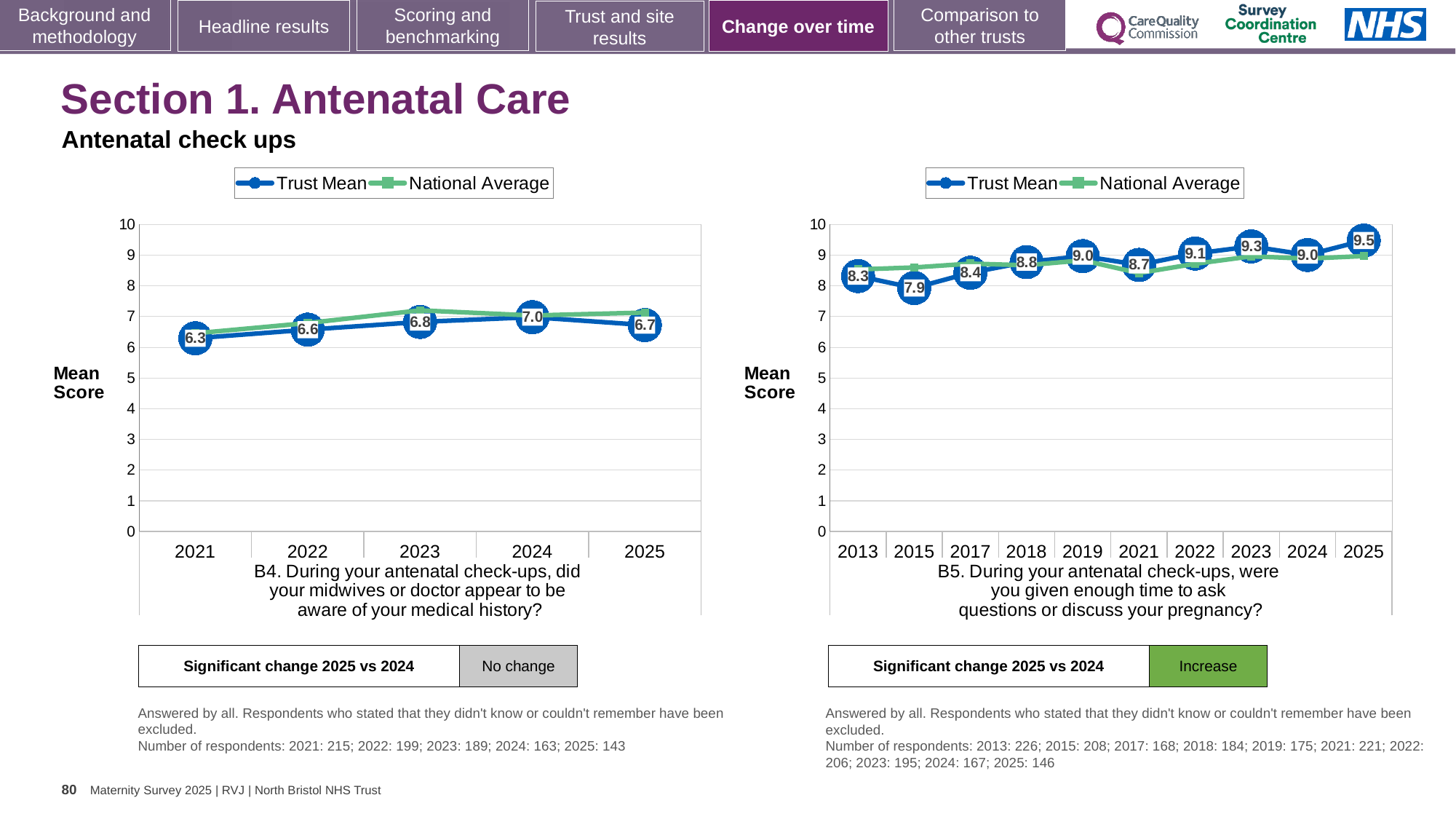
What kind of chart is the B4 chart on the left? Line chart In the B5 chart (right), is the Trust Mean score for 2023 or 2024 higher? 2023 In the B4 chart (left), what is the Trust Mean score for 2021? 6.3 In the B5 chart (right), what is the Trust Mean score for 2025? 9.5 In the B4 chart (left), what is the Trust Mean score for 2024? 7.0 In the B5 chart (right), is the National Average for 2013 greater or less than 9? less In the B4 chart (left), what is the difference between the Trust Mean scores for 2024 and 2021? 0.7 In the B4 chart (left), which year has the highest Trust Mean score? 2024 In the B5 chart (right), which year has the lowest Trust Mean score? 2015 In the B5 chart (right), how many series does the legend list? 2 In the B5 chart (right), what is the Trust Mean score for 2015? 7.9 In the B4 chart (left), how many years are shown on the x axis? 5